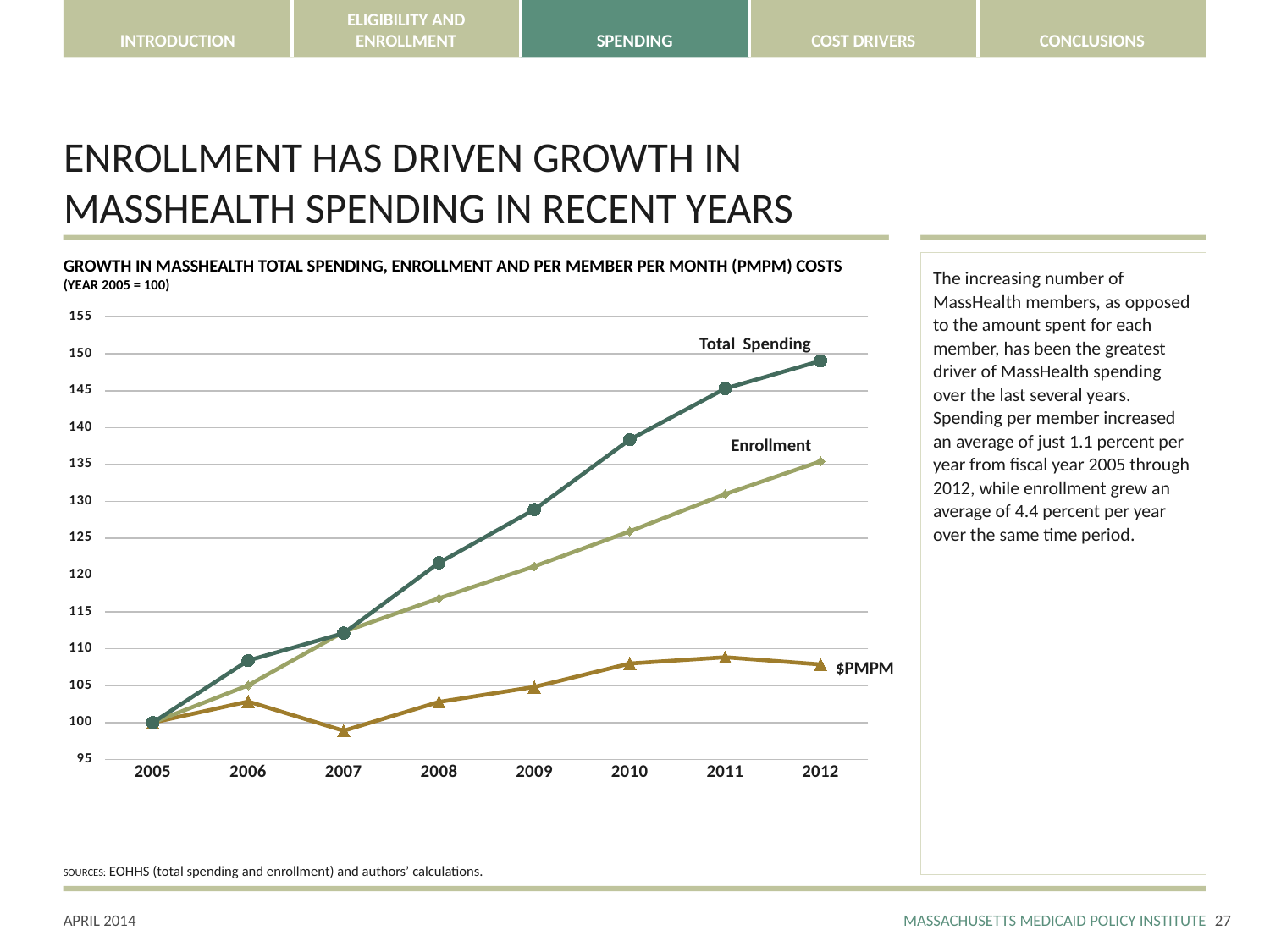
Is the value for Total Spending in 2010 greater or less than 140? less Does the Total Spending line rise or fall from 2005 to 2012? rise Which is larger in 2011, Enrollment or $PMPM? Enrollment Is the value for Total Spending in 2012 greater or less than 145? greater Is the value for $PMPM in 2007 greater or less than 100? less Which series has the lowest value in 2012? $PMPM What kind of chart is shown on the slide? line chart How many years are shown on the x axis of the chart? 8 What is the index value for Total Spending in 2005? 100 Which series has the highest value in 2012? Total Spending How many series are plotted on the chart? 3